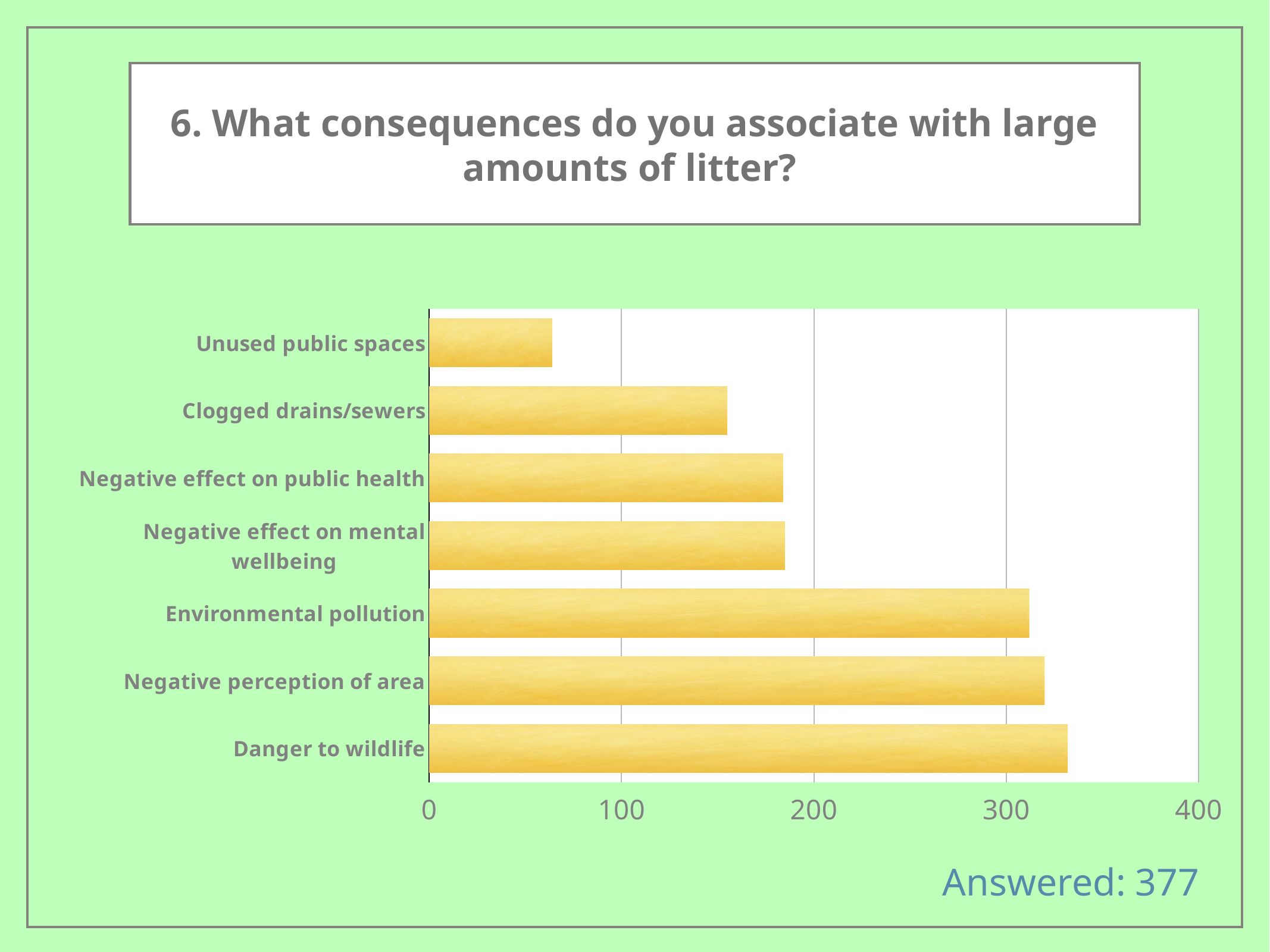
Is the value for Unused public spaces greater or less than 100? less Is the value for Clogged drains/sewers greater or less than 100? greater How many respondents answered the question, according to the slide? 377 Which category has the lowest value? Unused public spaces What kind of chart is shown on the slide? bar chart Is the value for Environmental pollution greater or less than 300? greater Which category has the highest value? Danger to wildlife Which is larger, the value for Environmental pollution or the value for Clogged drains/sewers? Environmental pollution How many categories are shown in the chart? 7 What is the title of the chart? 6. What consequences do you associate with large amounts of litter?